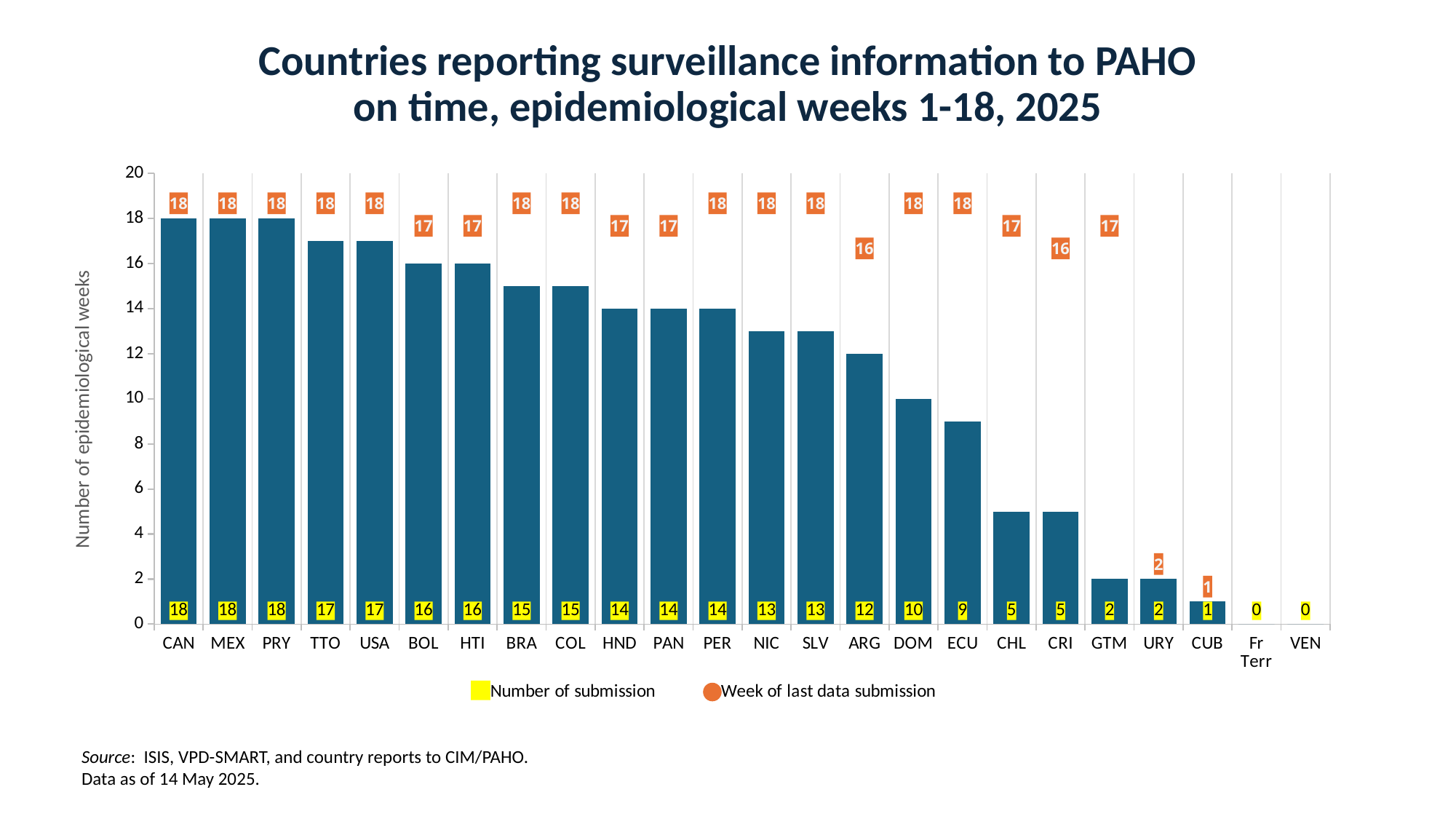
Do the number of submissions values rise or fall from left to right along the x axis? fall How many series does the legend list? 2 What is the week of last data submission for ARG? 16 What kind of chart is shown on the slide? bar chart What is the number of submissions for DOM? 10 How many countries or territories are shown on the x axis? 24 Is the number of submissions for ARG greater or less than 10? greater What is the difference between the number of submissions for CAN and for ECU? 9 What is the number of submissions for ECU? 9 Which has a higher number of submissions, DOM or CHL? DOM What is the week of last data submission for URY? 2 What colour are the 'Number of submission' labels in the legend? yellow